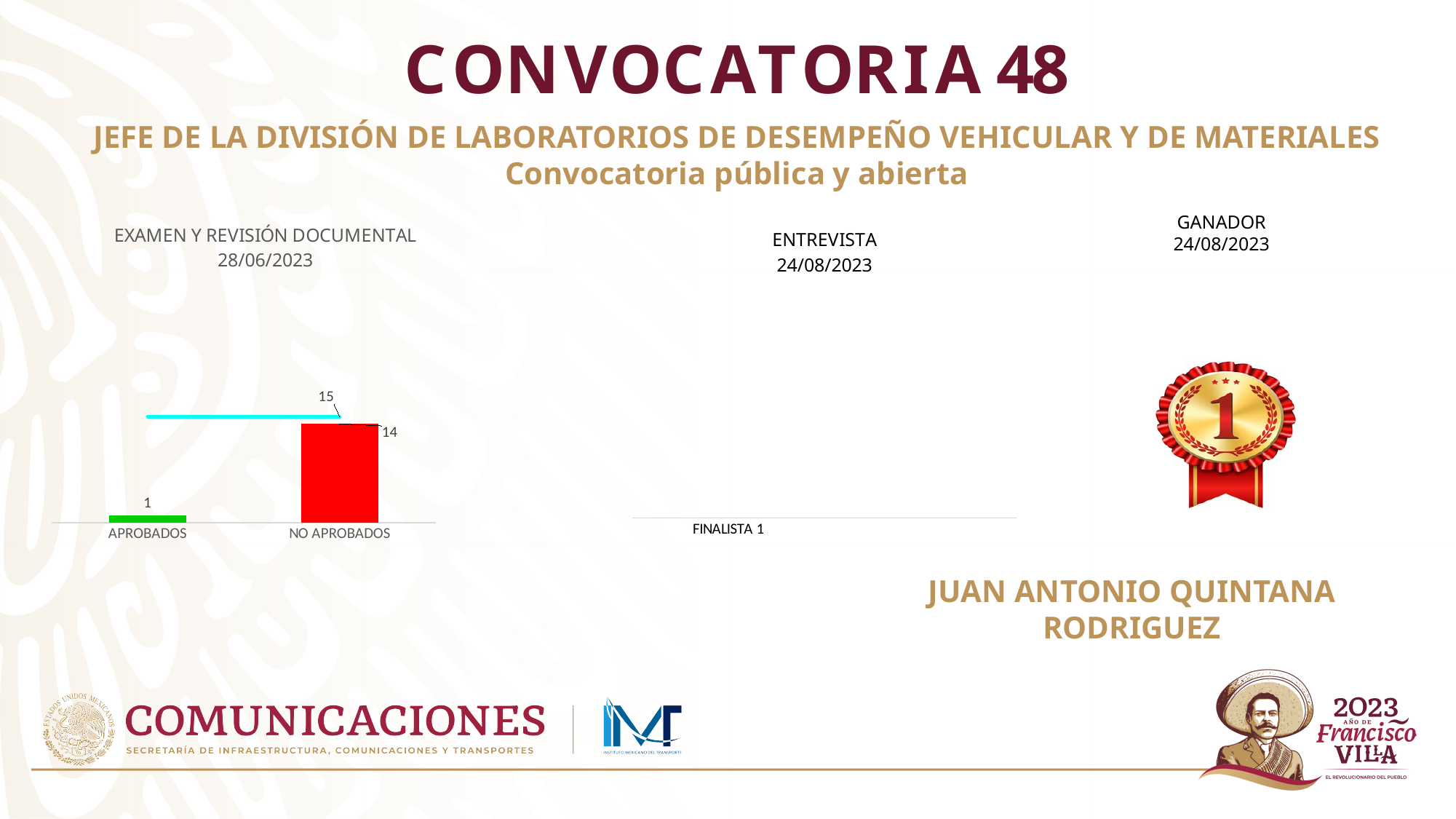
What kind of chart is the EXAMEN Y REVISIÓN DOCUMENTAL chart? combination bar and line chart In the EXAMEN Y REVISIÓN DOCUMENTAL chart, what is the value for NO APROBADOS? 14 In the EXAMEN Y REVISIÓN DOCUMENTAL chart, what colour is the APROBADOS bar? green In the EXAMEN Y REVISIÓN DOCUMENTAL chart, which category has the lowest value? APROBADOS In the EXAMEN Y REVISIÓN DOCUMENTAL chart, what is the difference between NO APROBADOS and APROBADOS? 13 In the EXAMEN Y REVISIÓN DOCUMENTAL chart, which is larger, APROBADOS or NO APROBADOS? NO APROBADOS How many categories are shown on the x axis of the EXAMEN Y REVISIÓN DOCUMENTAL chart? 2 In the EXAMEN Y REVISIÓN DOCUMENTAL chart, which category has the highest value? NO APROBADOS In the EXAMEN Y REVISIÓN DOCUMENTAL chart, what value is labelled on the cyan horizontal line? 15 What is the date shown under the EXAMEN Y REVISIÓN DOCUMENTAL chart title? 28/06/2023 In the EXAMEN Y REVISIÓN DOCUMENTAL chart, what is the combined total of APROBADOS and NO APROBADOS? 15 In the EXAMEN Y REVISIÓN DOCUMENTAL chart, what is the value for APROBADOS? 1